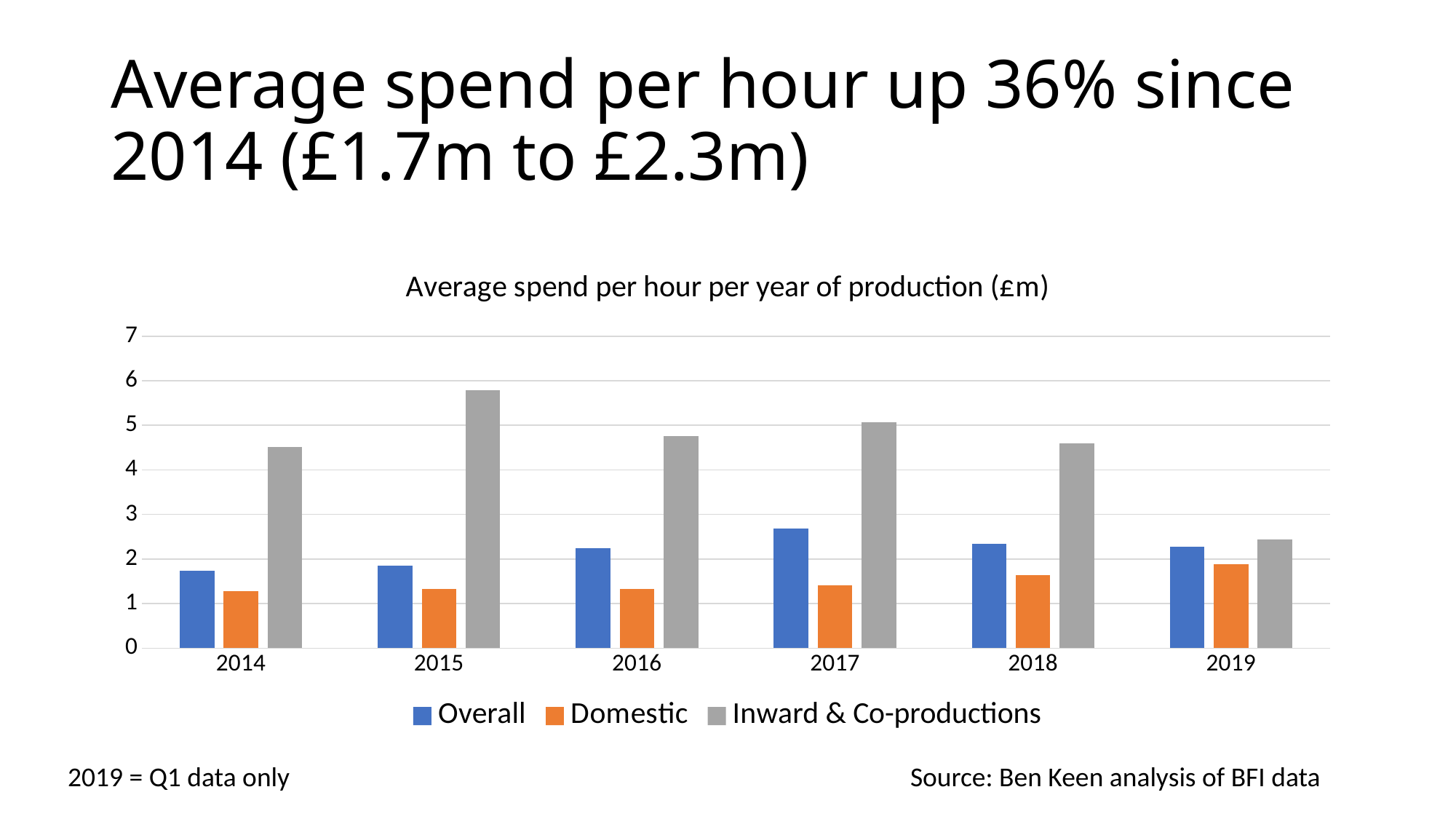
Is the Inward & Co-productions value for 2019 greater or less than 3? less Which is larger in 2016: the Overall value or the Inward & Co-productions value? Inward & Co-productions In which year is the Inward & Co-productions value lowest? 2019 How many series does the chart legend list? 3 Is the Inward & Co-productions value for 2015 greater or less than 5? greater In which year is the Domestic value highest? 2019 In which year is the Inward & Co-productions value highest? 2015 In which year is the Overall value highest? 2017 What kind of chart is shown on the slide? bar chart Is the Domestic value for 2014 greater or less than 2? less How many years are shown on the x axis of the chart? 6 What is the title of the chart? Average spend per hour per year of production (£m)